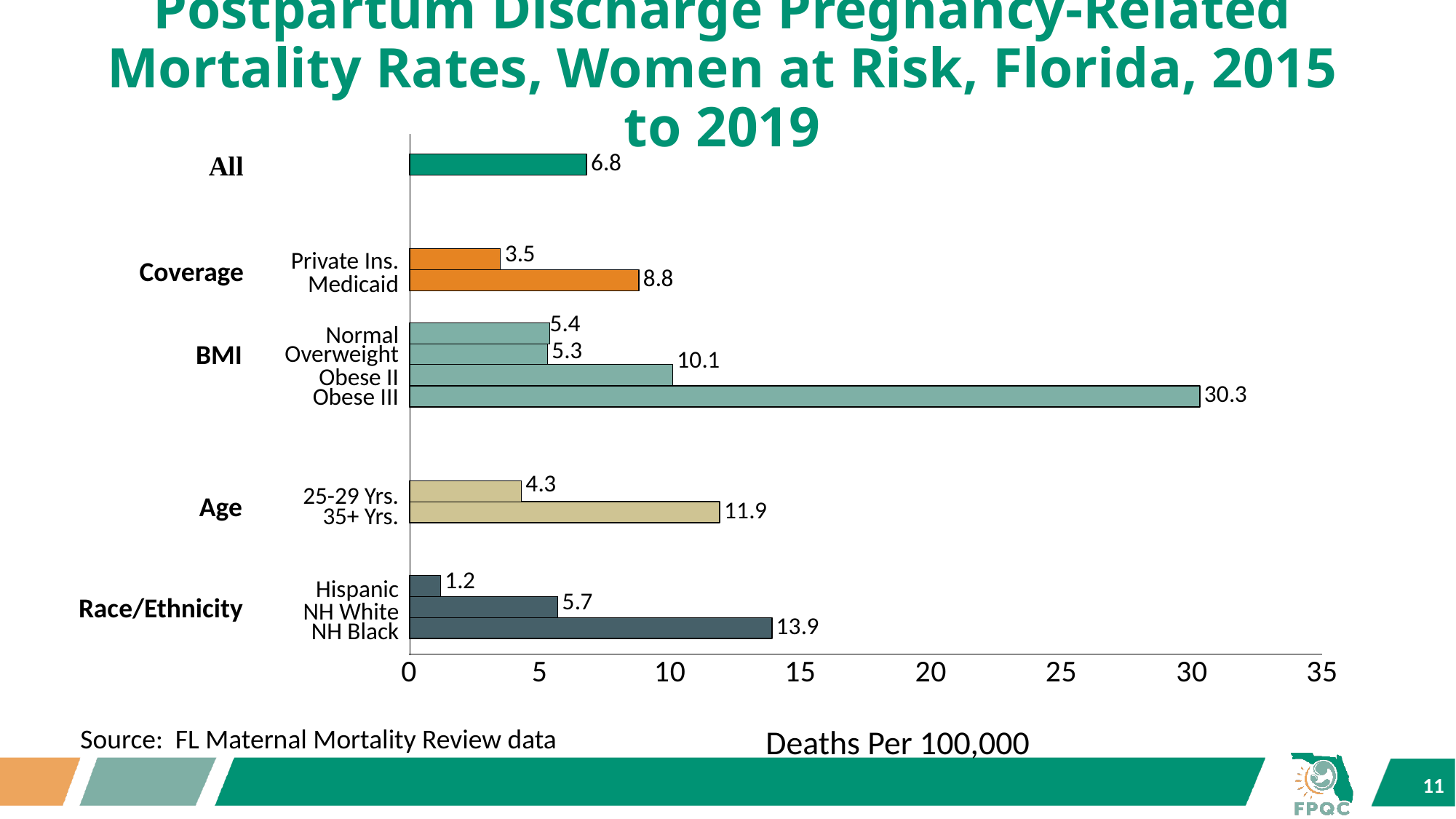
What type of chart is shown on the slide? Bar chart Which category has the highest mortality rate? Obese III What is the label of the horizontal axis? Deaths Per 100,000 What is the mortality rate for women with Medicaid coverage? 8.8 Is the mortality rate for NH Black women greater or less than 10? greater What is the mortality rate for NH Black women? 13.9 Which has a higher mortality rate, Medicaid or Private Ins.? Medicaid What is the mortality rate for the 'All' category? 6.8 What is the difference between the mortality rates for 35+ Yrs. and 25-29 Yrs.? 7.6 Which category has the lowest mortality rate? Hispanic How many bars are plotted in the chart? 12 What is the pregnancy-related mortality rate for Obese III women? 30.3